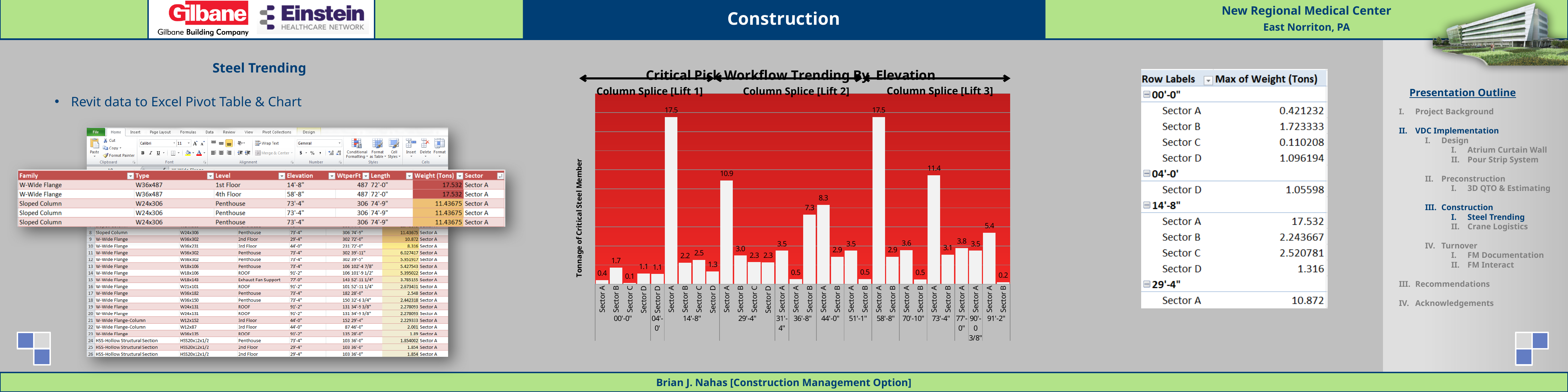
In the Critical Pick Workflow Trending By Elevation chart, what is the highest value shown on any bar? 17.5 What is the label on the vertical axis of the Critical Pick Workflow Trending By Elevation chart? Tonnage of Critical Steel Member In the Critical Pick Workflow Trending By Elevation chart, what is the difference between Sector B and Sector A at elevation 36'-8"? 6.8 In the Critical Pick Workflow Trending By Elevation chart, what is the value for Sector B at elevation 36'-8"? 7.3 In the Critical Pick Workflow Trending By Elevation chart, which is larger: Sector A at 29'-4" or Sector A at 73'-4"? Sector A at 73'-4" In the Critical Pick Workflow Trending By Elevation chart, what is the value for Sector A at elevation 14'-8"? 17.5 In the Critical Pick Workflow Trending By Elevation chart, what is the value for Sector A at elevation 73'-4"? 11.4 In the Critical Pick Workflow Trending By Elevation chart, which bar has the lowest value? Sector C at 00'-0" In the Critical Pick Workflow Trending By Elevation chart, what is the value for Sector A at elevation 29'-4"? 10.9 In the Critical Pick Workflow Trending By Elevation chart, what is the value for Sector A at elevation 91'-2"? 5.4 In the Critical Pick Workflow Trending By Elevation chart, what is the difference between Sector A at 14'-8" and Sector A at 29'-4"? 6.6 What kind of chart is the Critical Pick Workflow Trending By Elevation chart? Bar chart